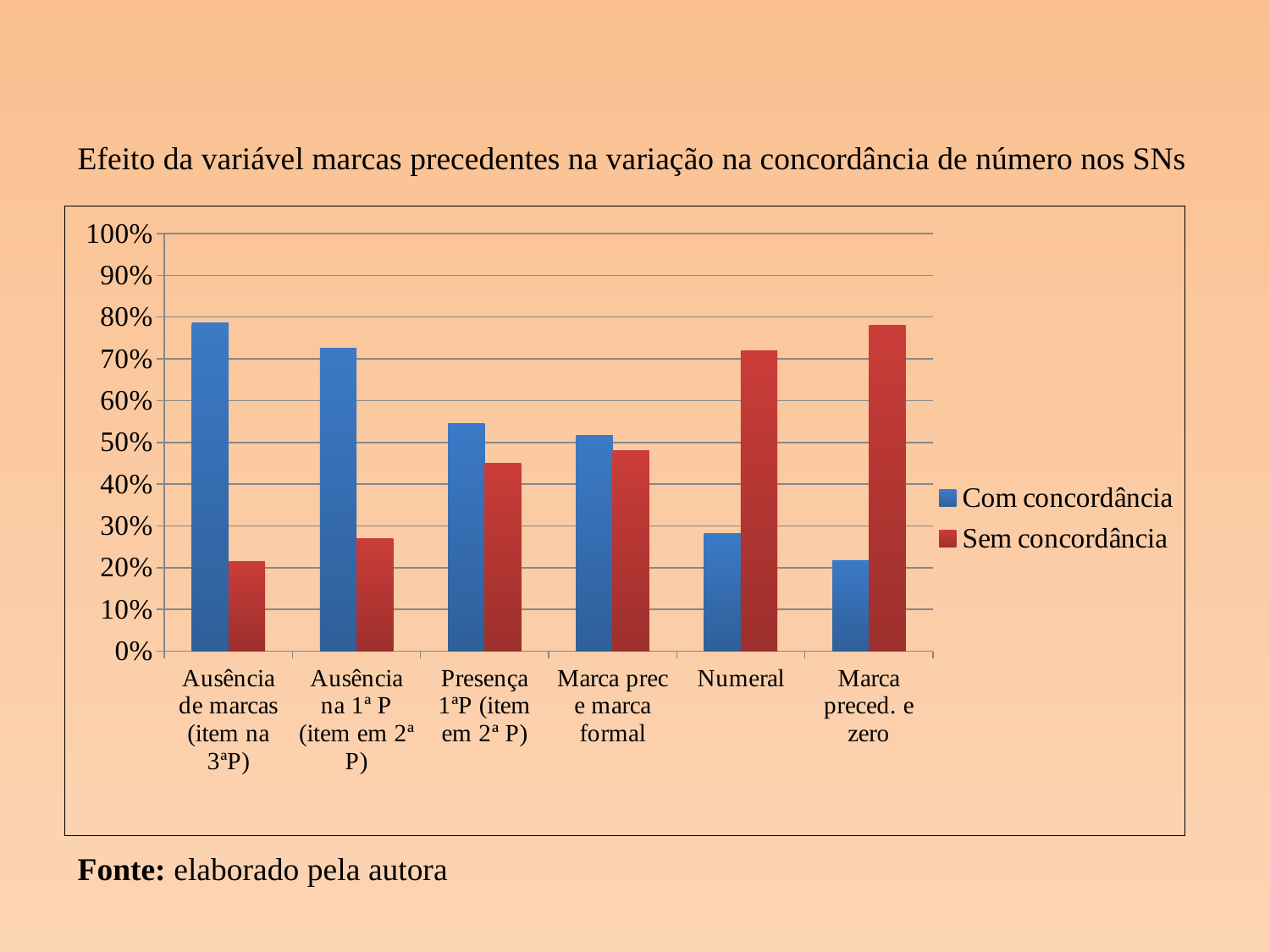
Is the Com concordância value for Numeral greater or less than 30%? less Is the Com concordância value for Ausência de marcas (item na 3ªP) greater or less than 70%? greater How many categories are shown on the x axis? 6 Which category has the highest value for Com concordância? Ausência de marcas (item na 3ªP) Which category has the lowest value for Sem concordância? Ausência de marcas (item na 3ªP) What is the title of the chart? Efeito da variável marcas precedentes na variação na concordância de número nos SNs What kind of chart is shown on the slide? bar chart Is the Sem concordância value for Numeral greater or less than 60%? greater For Numeral, which series has the larger value, Com concordância or Sem concordância? Sem concordância Which category has the lowest value for Com concordância? Marca preced. e zero How many series does the legend list? 2 Which category has the highest value for Sem concordância? Marca preced. e zero